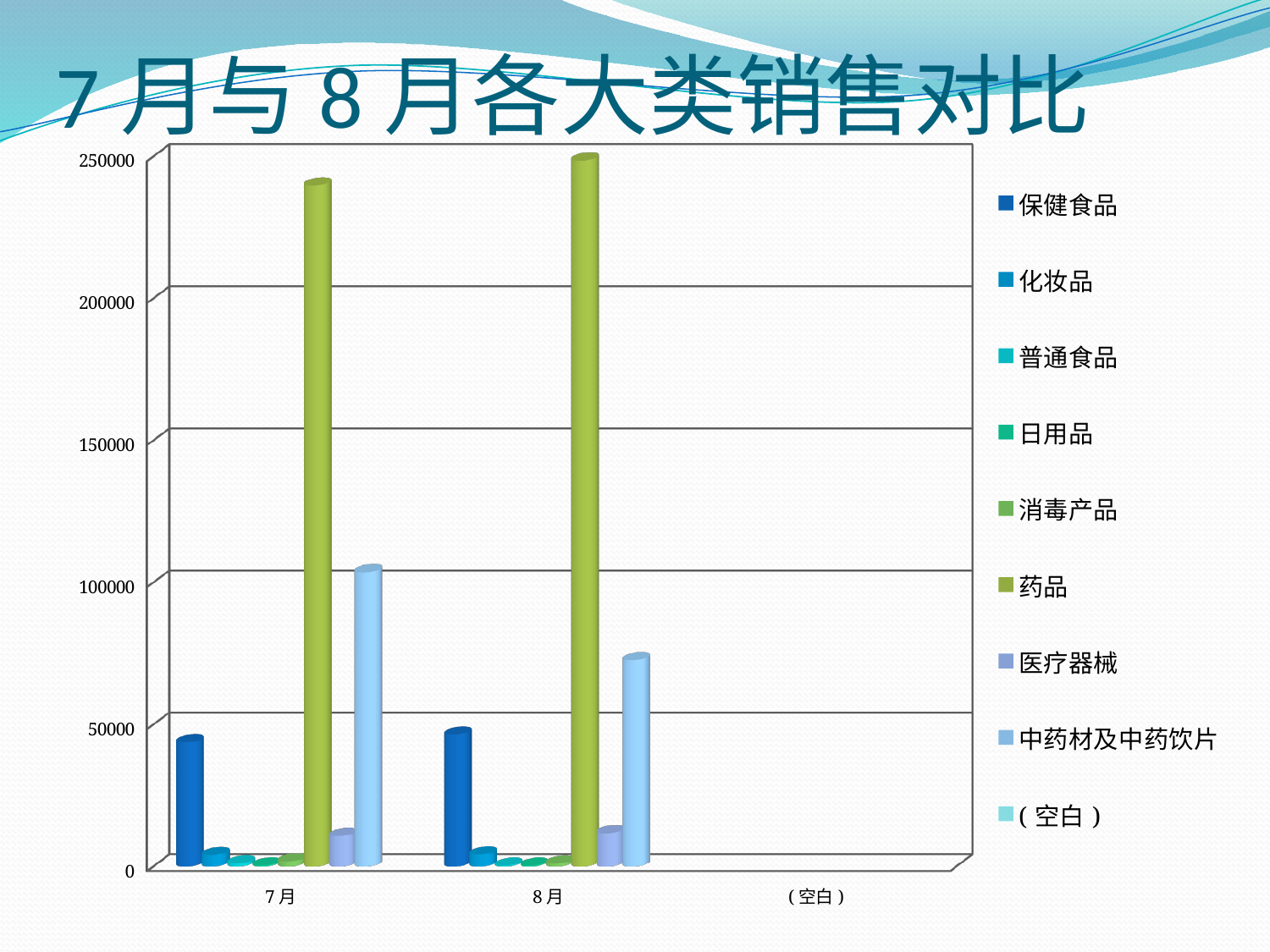
Is the value for 保健食品 in 7月 greater or less than 50000? less Which series has the highest value in the 7月 category? 药品 What kind of chart is shown on the slide? bar chart Is the value for 药品 in 7月 greater or less than 200000? greater Is the value for 中药材及中药饮片 in 8月 greater or less than 100000? less Which is larger in 8月: the value for 保健食品 or the value for 医疗器械? 保健食品 How many series does the legend list? 9 Which series has the highest value in the 8月 category? 药品 Which is larger: the value for 中药材及中药饮片 in 7月 or in 8月? 7月 How many categories are shown along the x axis? 3 What is the title of the slide? 7月与8月各大类销售对比